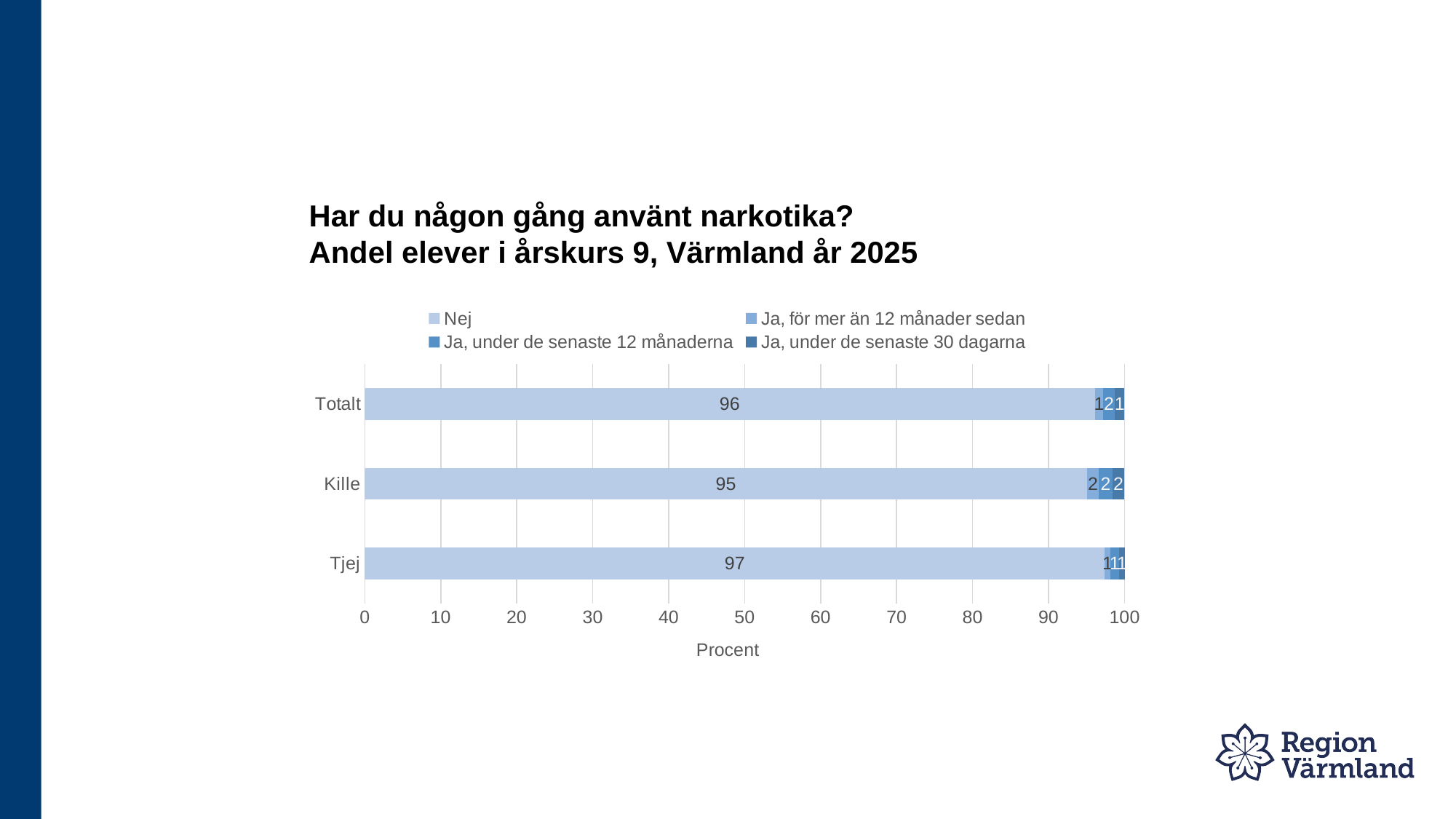
What is the 'Nej' value for Tjej? 97 Which category has the lowest 'Nej' value? Kille What is the difference between the 'Nej' values for Tjej and Kille? 2 What is the label of the horizontal axis? Procent What kind of chart is shown on the slide? Stacked bar chart What is the 'Nej' value for Kille? 95 How many series does the legend list? 4 Which has a larger 'Nej' value, Totalt or Kille? Totalt What is the 'Nej' value for Totalt? 96 Which category has the highest 'Nej' value? Tjej How many categories are shown on the vertical axis? 3 Is the 'Nej' value for Kille greater or less than 90? greater